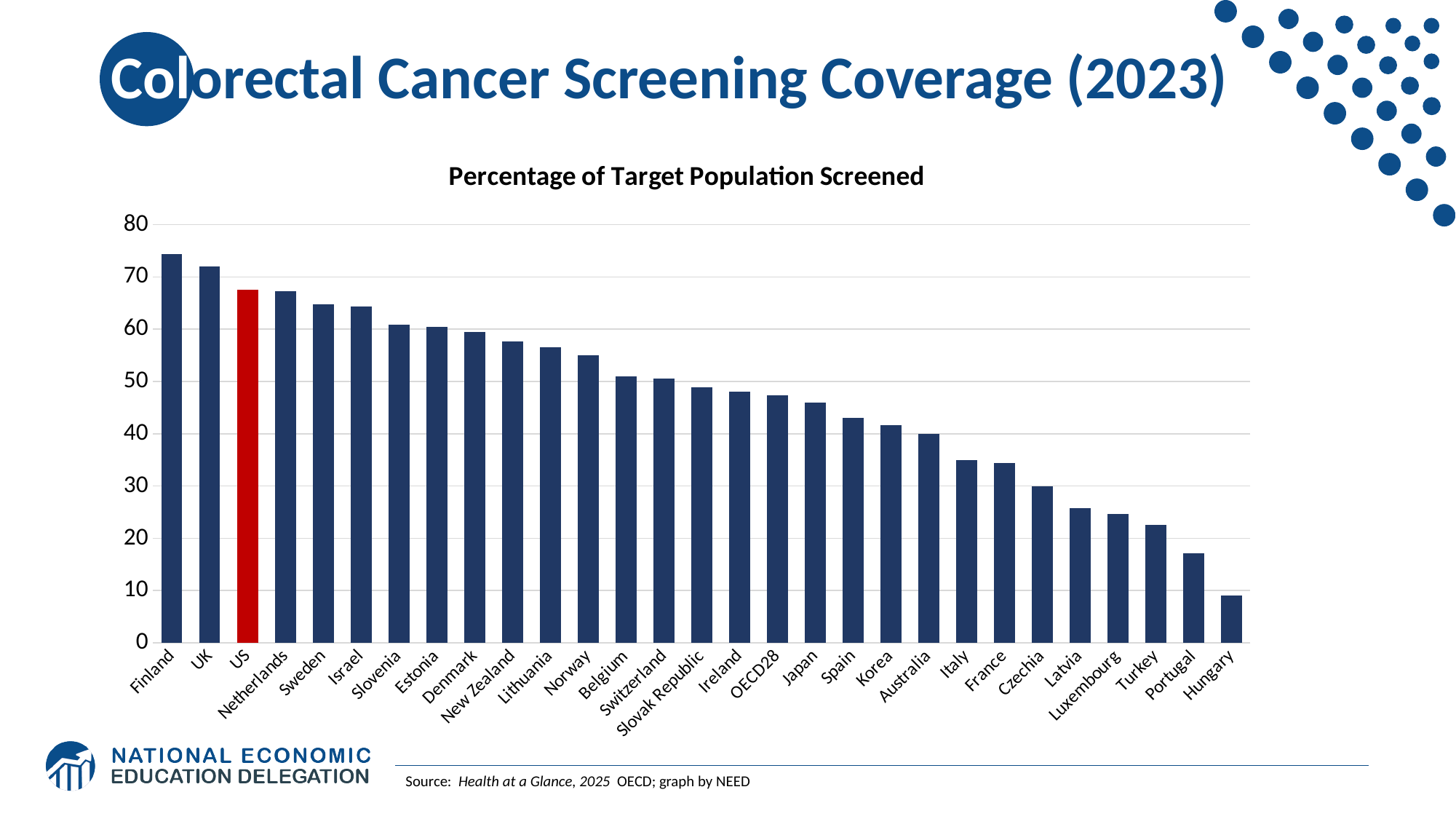
Which has a higher value, Norway or Spain? Norway Which country has the highest percentage of target population screened? Finland Is the value for Finland greater or less than 70? greater How many categories (bars) are plotted on the chart? 29 Is the value for Japan greater or less than 40? greater Is the value for Hungary greater or less than 10? less Which country has the lowest percentage of target population screened? Hungary Which bar is coloured red rather than dark blue? US Do the values rise or fall moving from left to right along the x axis? fall What kind of chart is shown on the slide? bar chart